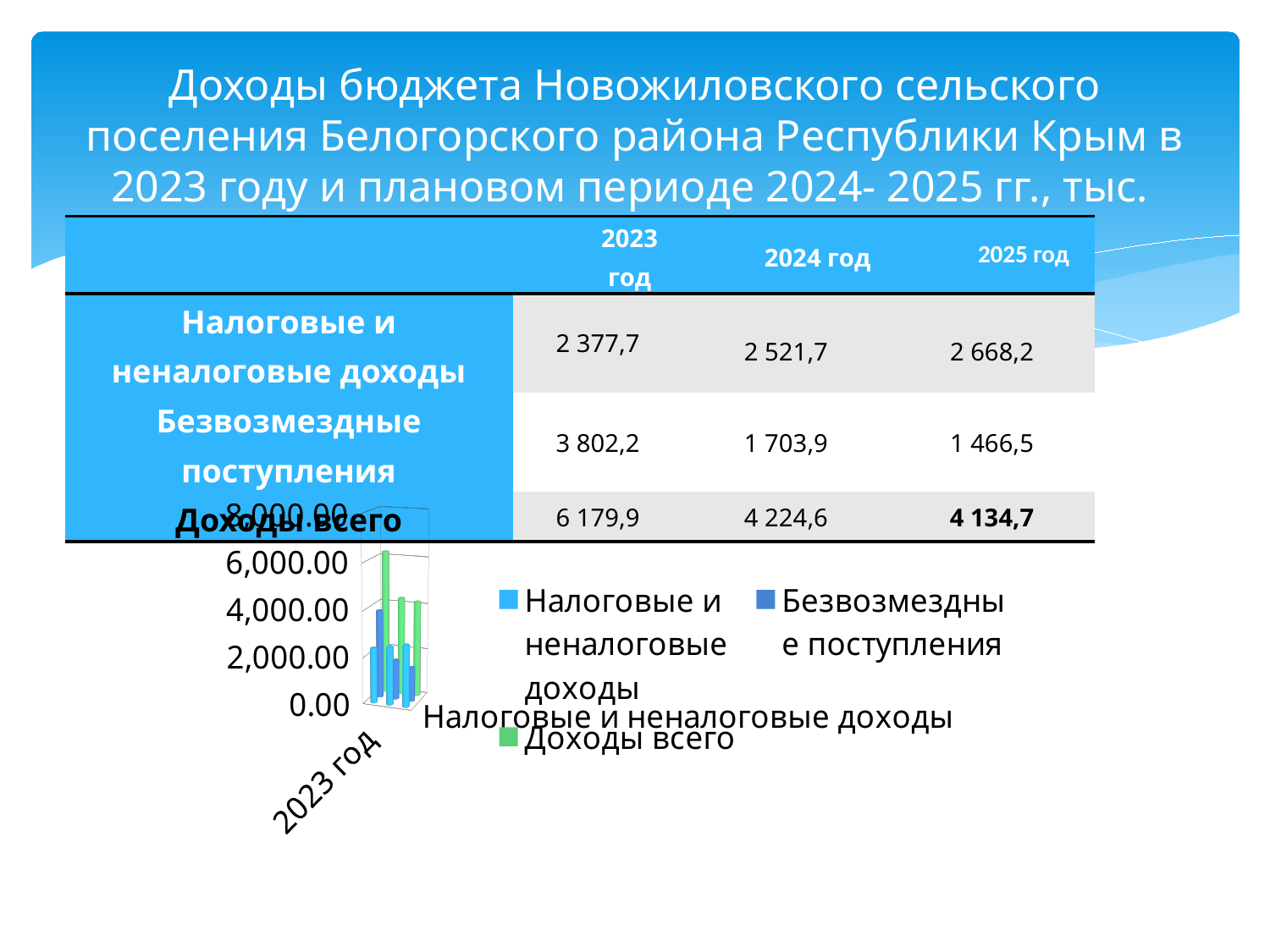
Which series has the shortest bar for 2023 год in the chart? Налоговые и неналоговые доходы Is the bar for Безвозмездные поступления in 2023 год greater or less than 2,000.00? greater How many series does the chart legend list? 3 What is the highest value shown on the chart's vertical axis? 8,000.00 Which series has the tallest bar in the chart? Доходы всего Is the bar for Налоговые и неналоговые доходы in 2023 год greater or less than 4,000.00? less For 2023 год, which bar is taller: Безвозмездные поступления or Налоговые и неналоговые доходы? Безвозмездные поступления Is the tallest bar for Доходы всего greater or less than 4,000.00? greater What are the three series listed in the chart legend? Налоговые и неналоговые доходы, Безвозмездные поступления, Доходы всего What kind of chart is shown on the slide? bar chart